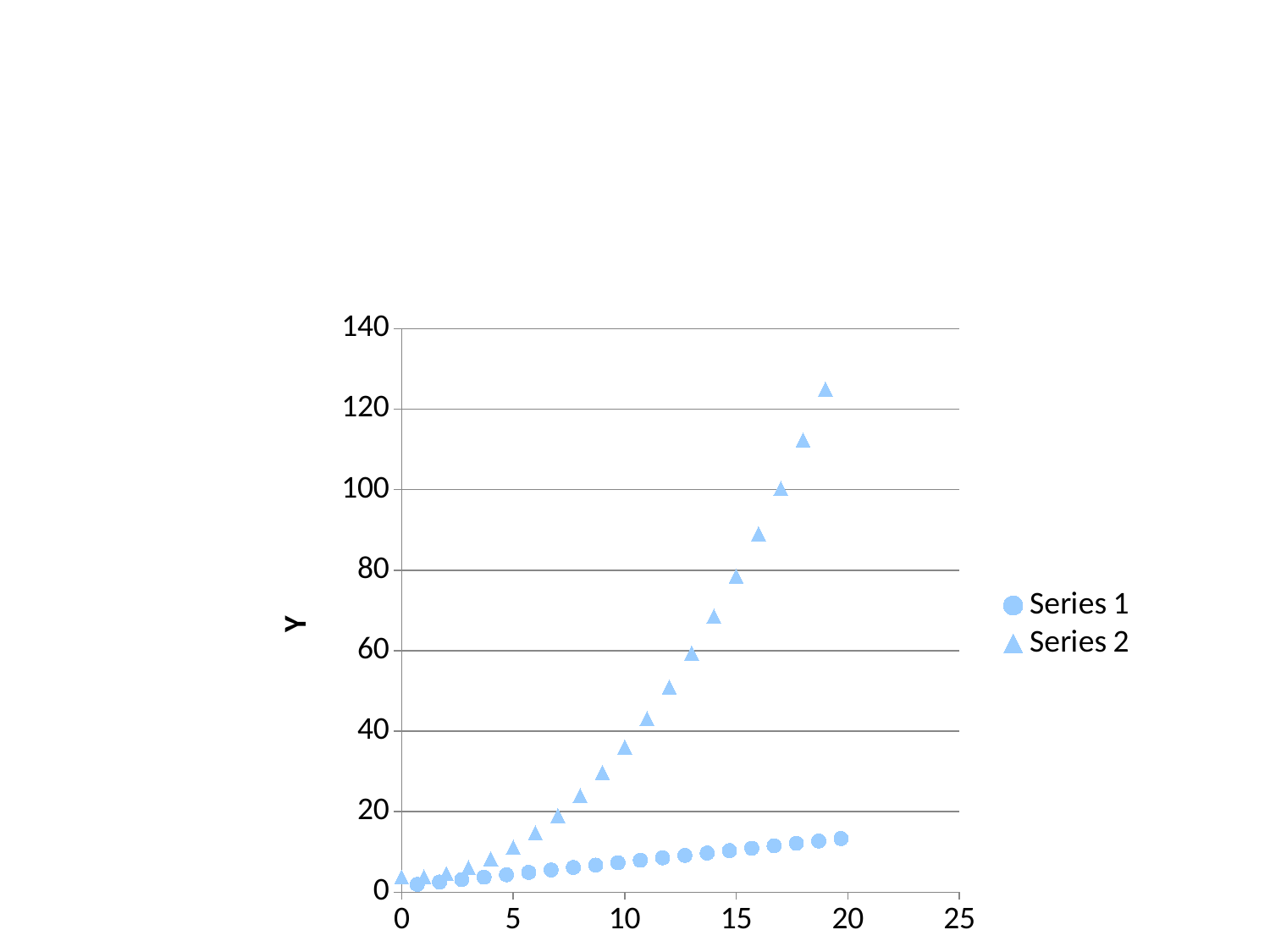
What kind of chart is shown on the slide? scatter chart How many series does the legend list? 2 Is the highest value of Series 1 greater or less than 20? less Is the value of Series 2 at x = 10 greater or less than 40? less Is the highest value of Series 2 greater or less than 120? greater Which series rises more steeply, Series 1 or Series 2? Series 2 Do the values of Series 2 rise or fall as x increases? rise At x = 15, which series has the higher value, Series 1 or Series 2? Series 2 What are the names of the series listed in the legend? Series 1 and Series 2 What is the title of the vertical axis? Y Do the values of Series 1 rise or fall as x increases? rise